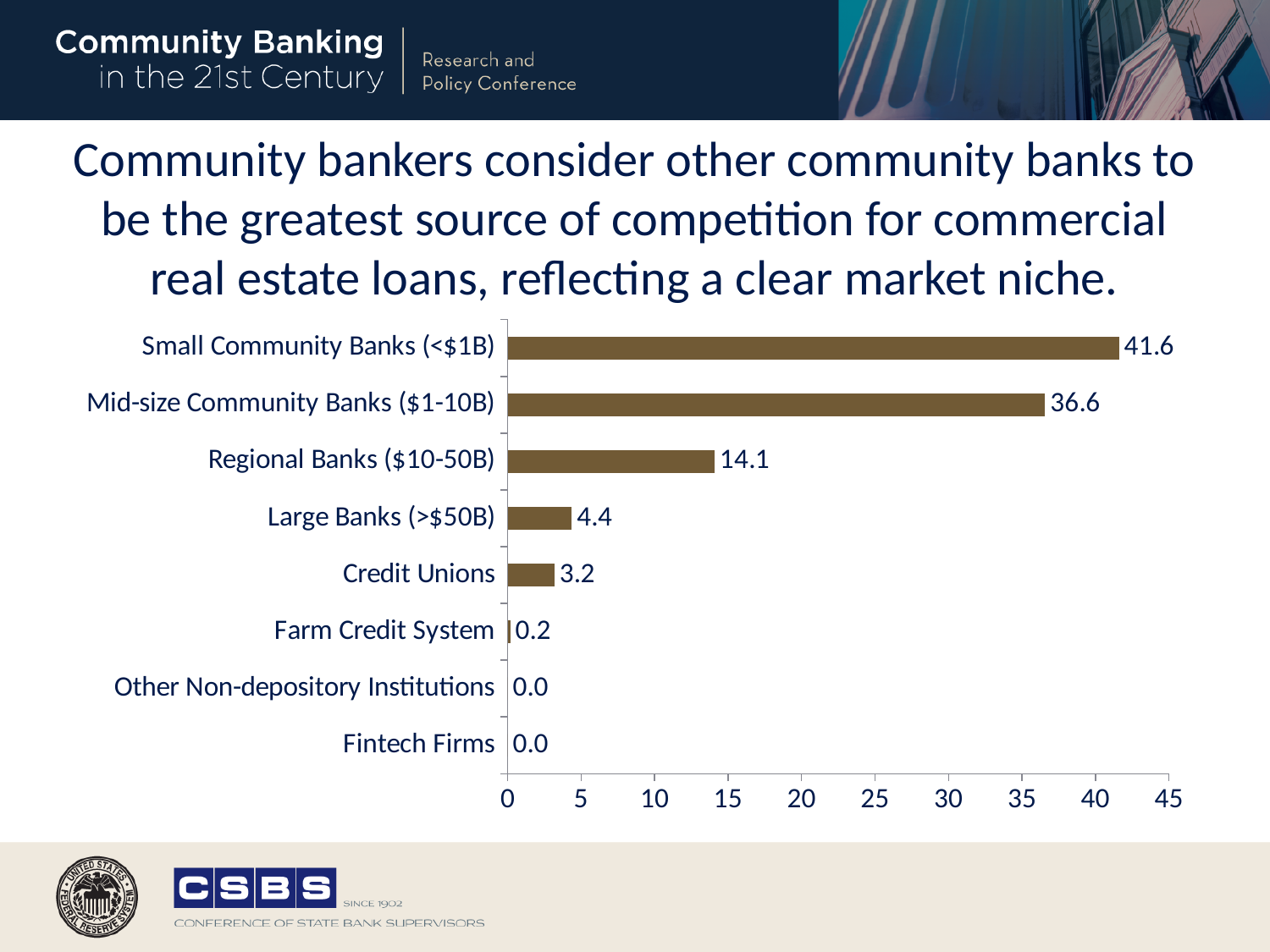
Which category has the highest value? Small Community Banks (<$1B) What kind of chart is shown on the slide? Bar chart How many categories are shown in the chart? 8 How many categories have a value of 0.0? 2 Which is larger, the value for Large Banks (>$50B) or the value for Credit Unions? Large Banks (>$50B) What is the difference between the values for Regional Banks ($10-50B) and Large Banks (>$50B)? 9.7 What is the value for Regional Banks ($10-50B)? 14.1 What is the value for Farm Credit System? 0.2 What is the value for Credit Unions? 3.2 What is the value for Small Community Banks (<$1B)? 41.6 Is the value for Mid-size Community Banks ($1-10B) greater or less than 35? greater What is the difference between the values for Small Community Banks (<$1B) and Mid-size Community Banks ($1-10B)? 5.0